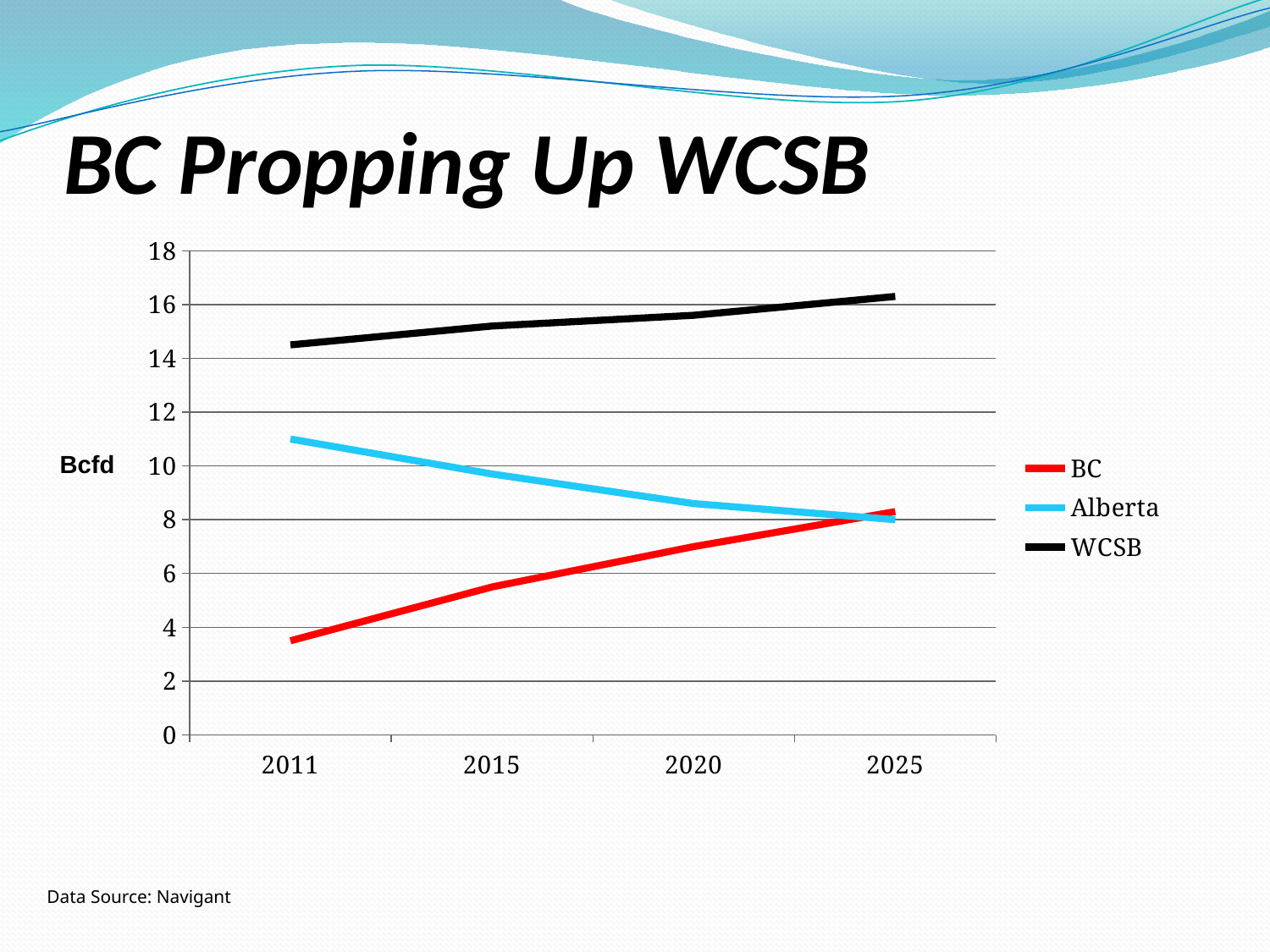
Is the value for BC in 2011 greater or less than 4? less What label is shown on the y axis of the chart? Bcfd Does the Alberta line rise or fall from 2011 to 2025? fall Does the BC line rise or fall from 2011 to 2025? rise How many years are labelled on the x axis? 4 Which series has the lowest value in 2011? BC What kind of chart is shown on the slide? line chart How many series does the legend list? 3 Is the value for Alberta in 2011 greater or less than 10? greater Is the value for WCSB in 2025 greater or less than 16? greater In 2011, which is larger, the value for Alberta or the value for BC? Alberta Which series has the highest values across the whole chart? WCSB